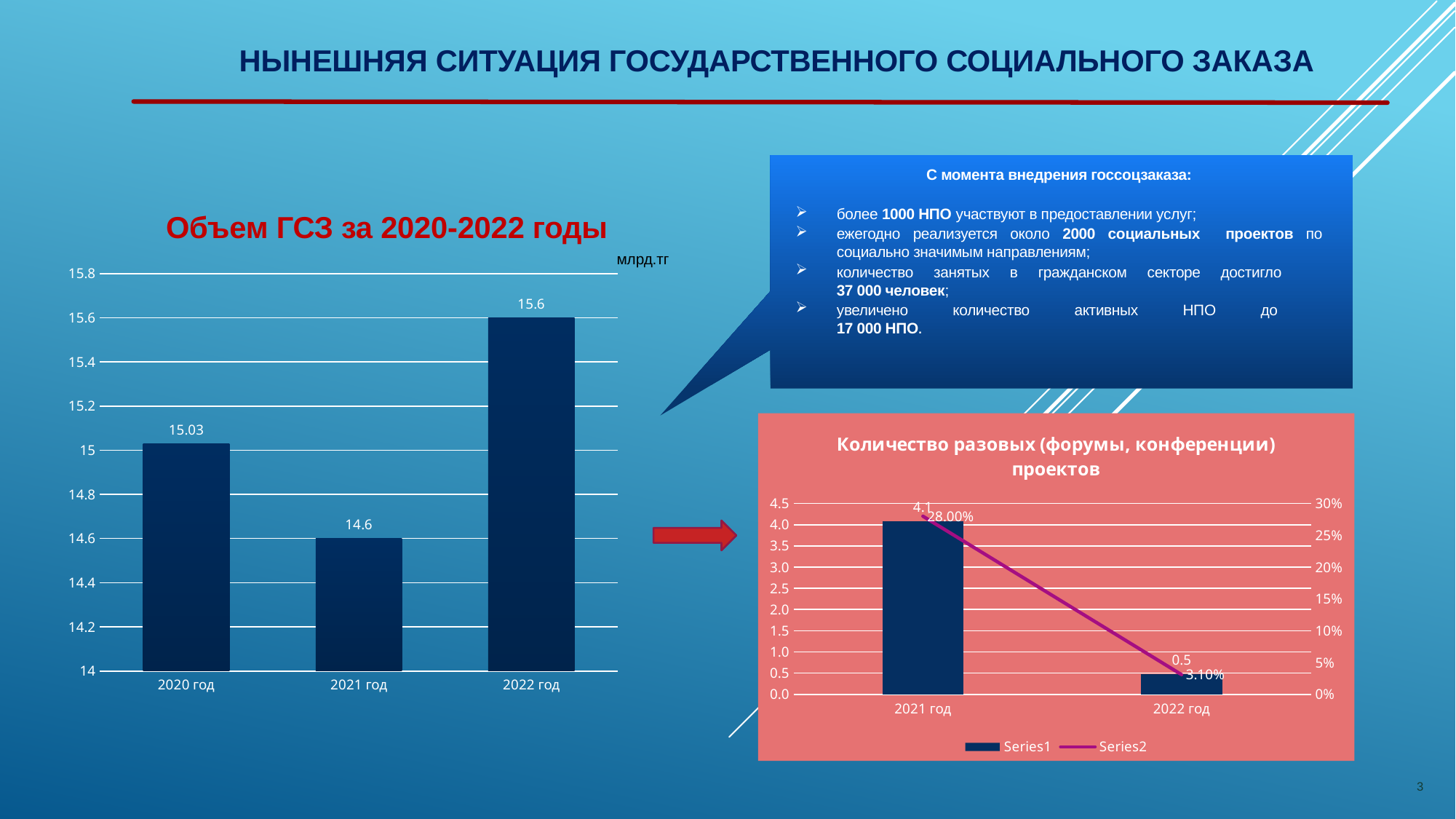
In the chart 'Количество разовых (форумы, конференции) проектов', do the values rise or fall from 2021 год to 2022 год? fall In the chart 'Количество разовых (форумы, конференции) проектов', how many series does the legend list? 2 In the chart 'Объем ГСЗ за 2020-2022 годы', what is the difference between the values for 2022 год and 2021 год? 1 In the chart 'Объем ГСЗ за 2020-2022 годы', what is the value for 2020 год? 15.03 In the chart 'Объем ГСЗ за 2020-2022 годы', which year has the highest value? 2022 год In the chart 'Количество разовых (форумы, конференции) проектов', what is the Series2 value for 2022 год? 3.10% In the chart 'Объем ГСЗ за 2020-2022 годы', which year has the lowest value? 2021 год What type of chart is 'Объем ГСЗ за 2020-2022 годы'? bar chart In the chart 'Количество разовых (форумы, конференции) проектов', what is the bar value for 2021 год? 4.1 In the chart 'Объем ГСЗ за 2020-2022 годы', how many years are shown on the x axis? 3 In the chart 'Объем ГСЗ за 2020-2022 годы', what unit is shown above the axis? млрд.тг In the chart 'Объем ГСЗ за 2020-2022 годы', what is the value for 2021 год? 14.6